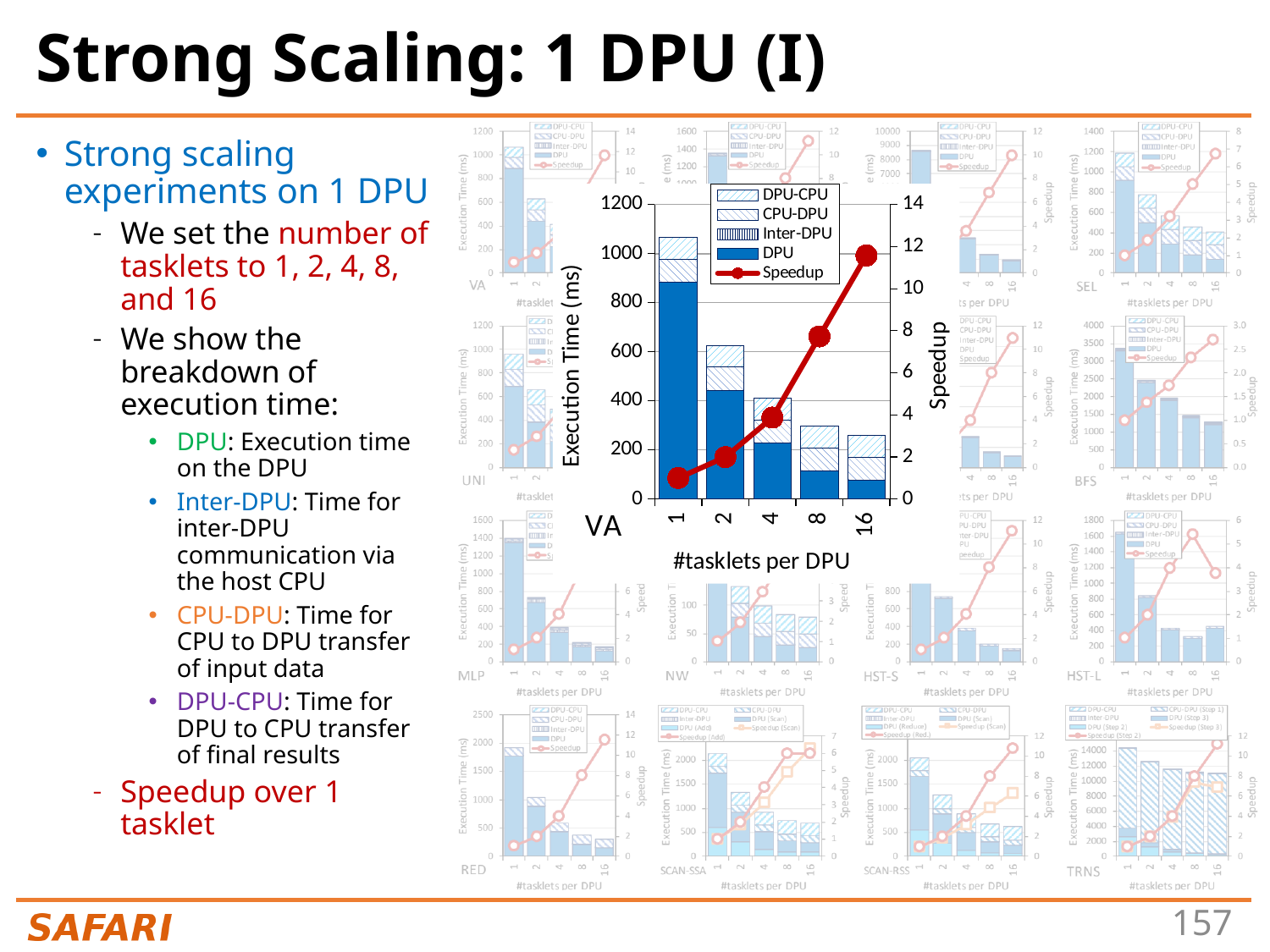
In the enlarged VA chart, is the total execution time for 8 tasklets greater or less than 400 ms? less In the enlarged VA chart, is the total execution time for 2 tasklets greater or less than 800 ms? less In the enlarged VA chart, what kind of chart is used to show execution time? Stacked bar chart (with a line for speedup) In the enlarged VA chart, what is the label of the x axis? #tasklets per DPU In the enlarged VA chart, how many entries does the legend list? 5 In the enlarged VA chart, does the total execution time rise or fall as the number of tasklets increases? fall In the enlarged VA chart, how many tasklet counts are shown on the x axis? 5 In the enlarged VA chart, is the total execution time for 1 tasklet greater or less than 1000 ms? greater In the enlarged VA chart, which number of tasklets has the highest speedup? 16 In the enlarged VA chart, which number of tasklets has the highest total execution time? 1